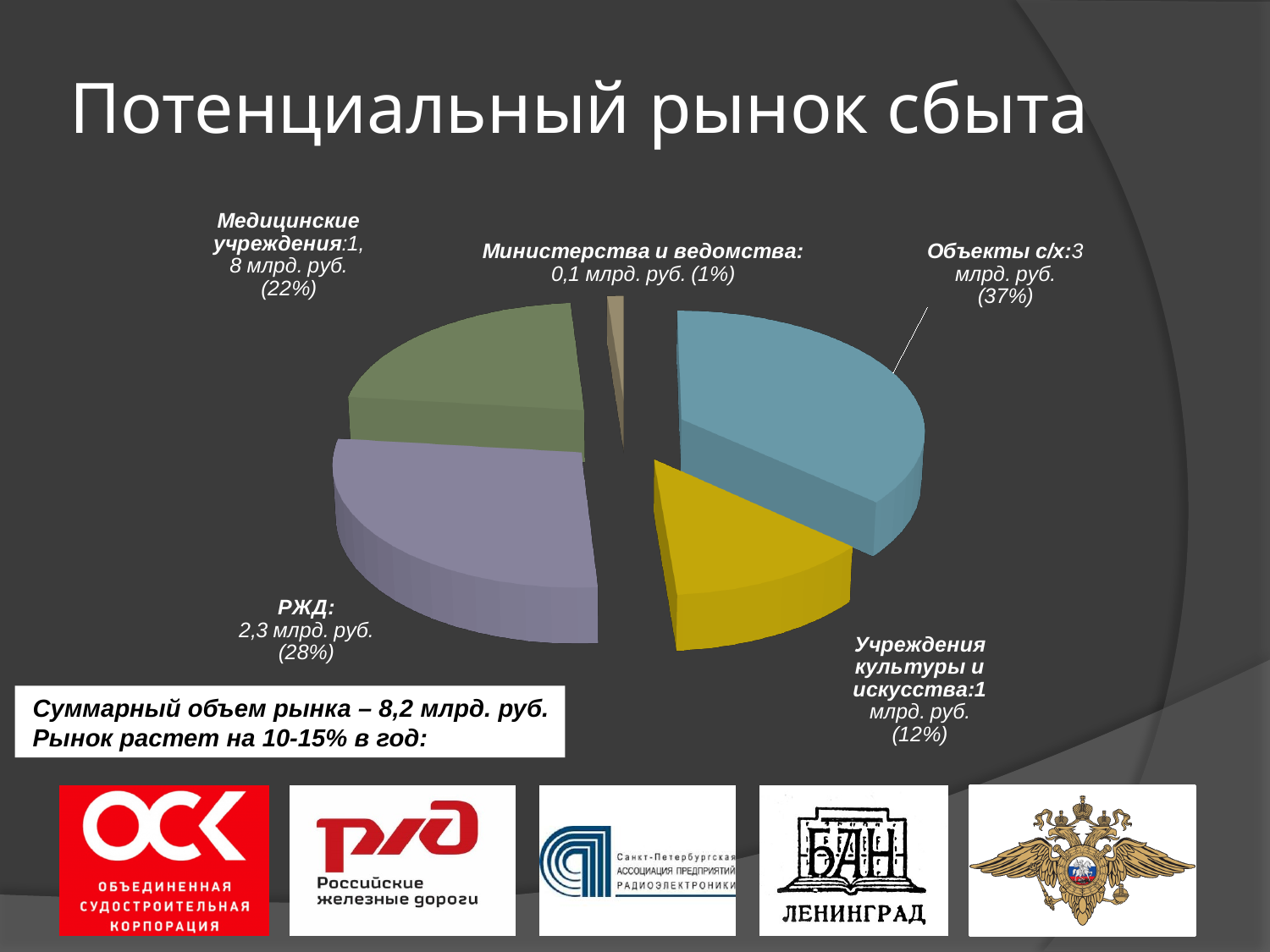
Which category has the largest slice of the pie? Объекты с/х What is the title of the slide containing the pie chart? Потенциальный рынок сбыта What is the value for Медицинские учреждения? 1,8 млрд. руб. Which is larger, the share for Медицинские учреждения or the share for Учреждения культуры и искусства? Медицинские учреждения Which category has the smallest slice of the pie? Министерства и ведомства What share of the pie does РЖД account for? 28% What kind of chart is shown on the slide? pie chart What is the total market volume stated on the slide? 8,2 млрд. руб. What share of the pie does Министерства и ведомства account for? 1% What is the value for Объекты с/х? 3 млрд. руб. How many slices does the pie chart have? 5 What is the difference in percentage points between Объекты с/х and РЖД? 9 percentage points